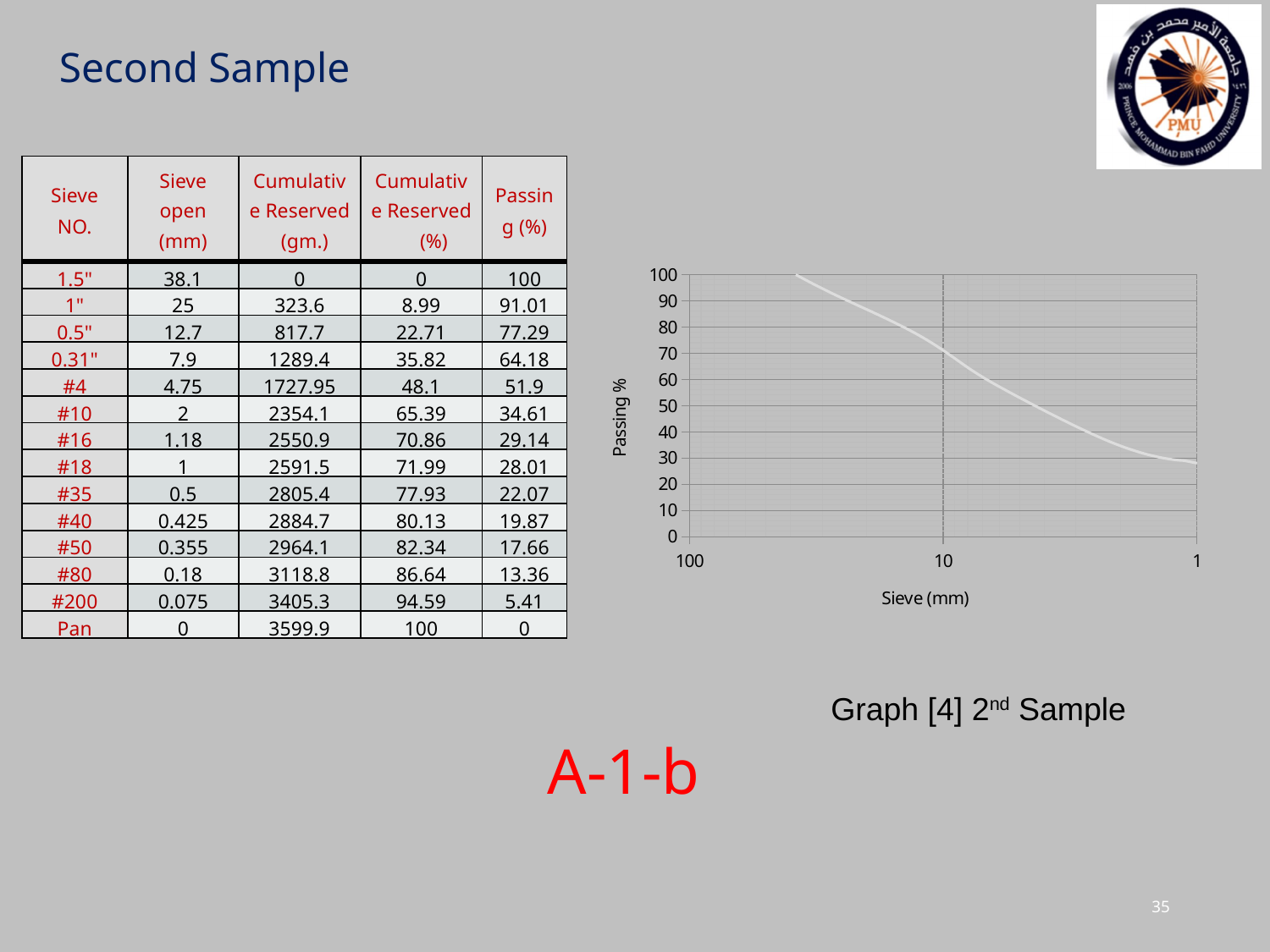
At which end of the x axis does the curve reach its lowest Passing % value, the 100 mm end or the 1 mm end? 1 mm end Moving from left to right along the x axis, do the plotted Passing % values rise or fall? fall What is the highest value shown on the y axis of the chart? 100 Is the Passing % value at a sieve size of 1 mm greater or less than 40? less Is the Passing % value at a sieve size of 10 mm greater or less than 80? less Which sieve size has the higher Passing % on the chart, 10 mm or 1 mm? 10 mm What is the title of the x axis of the chart? Sieve (mm) What is the Passing % value at the left-most (largest sieve size) point of the curve? 100 What is the title of the y axis of the chart? Passing % Is the Passing % value at a sieve size of 1 mm greater or less than 20? greater What kind of chart is shown on the slide? line chart